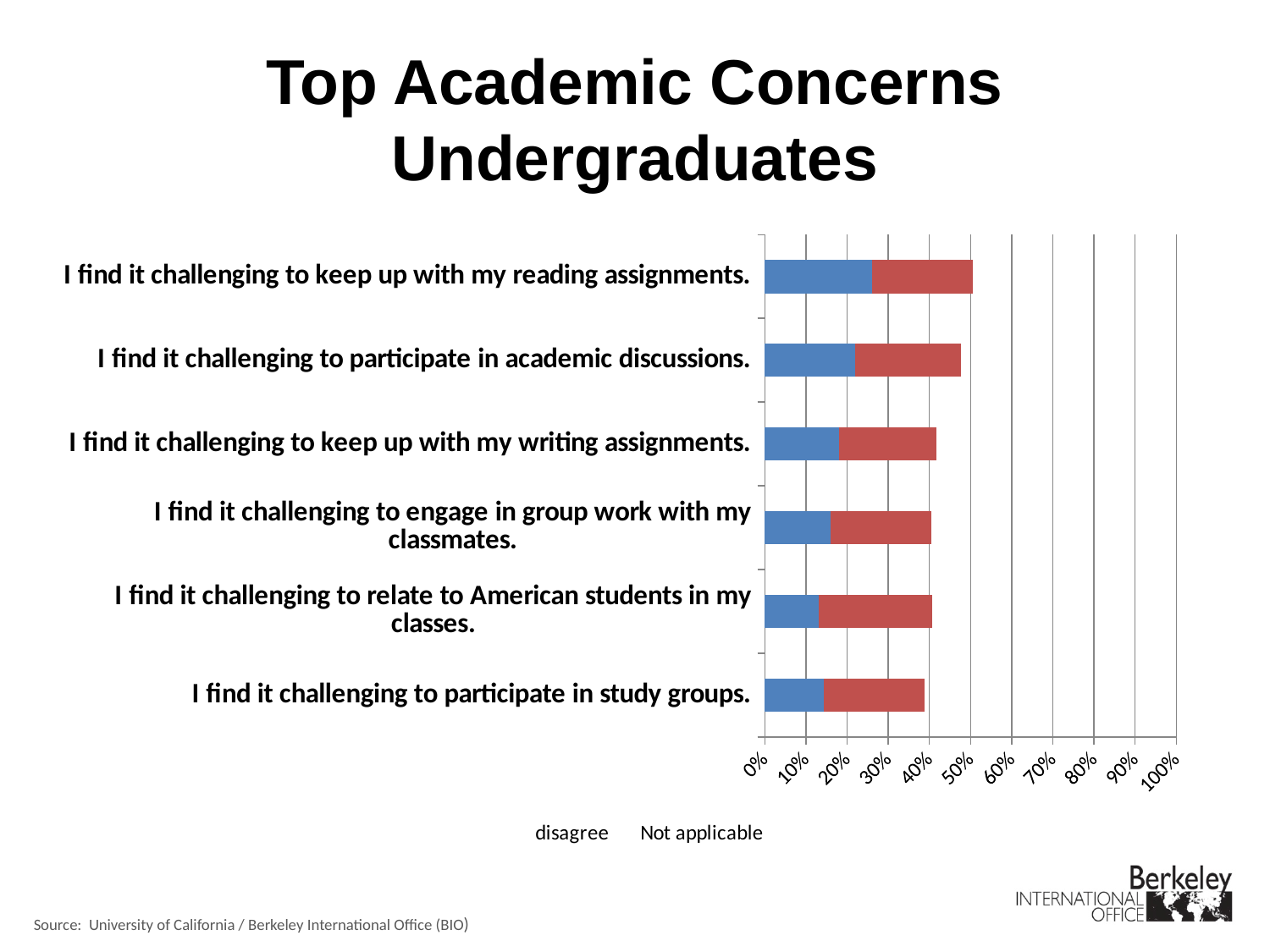
Which has the longer total bar: "I find it challenging to participate in academic discussions." or "I find it challenging to keep up with my writing assignments."? I find it challenging to participate in academic discussions. Is the total bar for "I find it challenging to keep up with my writing assignments." greater or less than 50%? less What is the title of the slide containing the chart? Top Academic Concerns Undergraduates Is the blue segment for "I find it challenging to relate to American students in my classes." greater or less than 20%? less What kind of chart is shown on the slide? Stacked bar chart How many statements (categories) are plotted in the chart? 6 Which statement has the longest total bar? I find it challenging to keep up with my reading assignments. Is the total bar for "I find it challenging to keep up with my reading assignments." greater or less than 40%? greater How many series does the legend list? 2 What are the two entries listed in the chart legend? disagree, Not applicable